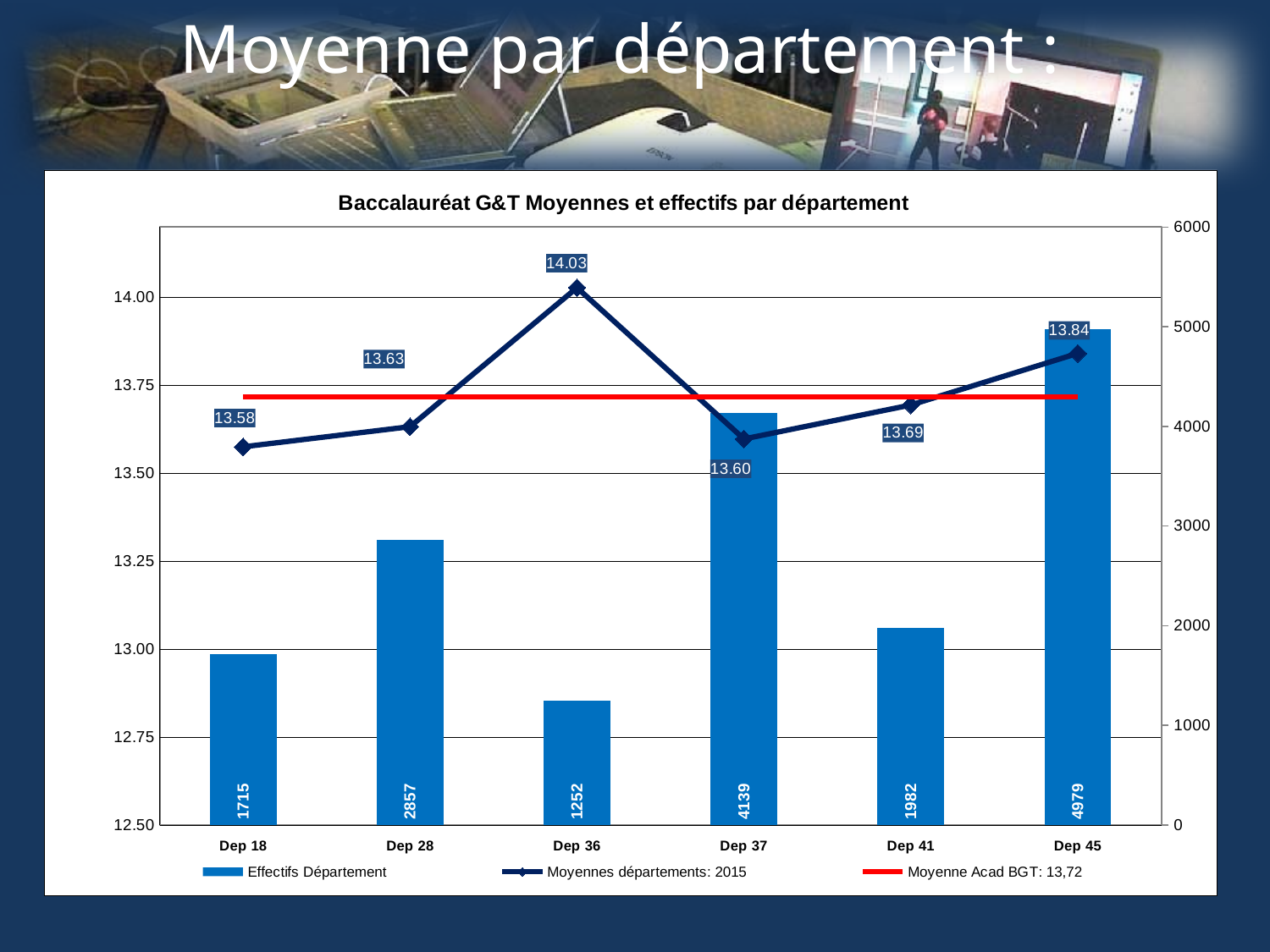
What is the title of the chart? Baccalauréat G&T Moyennes et effectifs par département What is the Moyennes départements: 2015 value for Dep 41? 13.69 Is the Effectifs Département value for Dep 18 greater or less than 2000? less How many departments are shown on the x axis? 6 Which department has the highest Effectifs Département? Dep 45 What is the difference in Effectifs Département between Dep 45 and Dep 36? 3727 Which department has the lowest Moyennes départements: 2015 value? Dep 18 What is the value of Effectifs Département for Dep 37? 4139 What value does the legend give for the Moyenne Acad BGT line? 13,72 Which has a larger Effectifs Département, Dep 28 or Dep 41? Dep 28 How many series does the legend list? 3 What is the Moyennes départements: 2015 value for Dep 36? 14.03